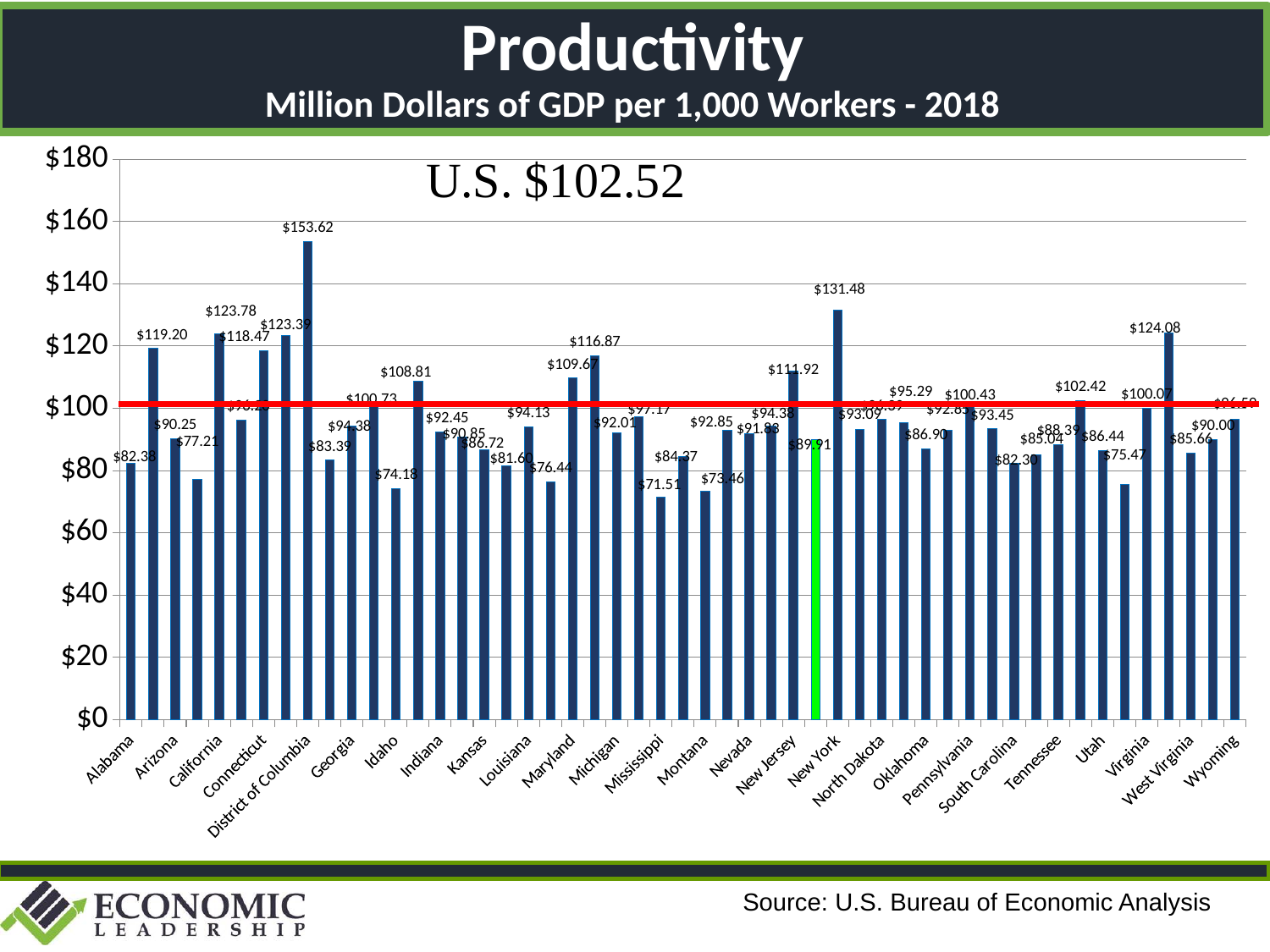
Is the productivity value for Montana greater or less than $80? less What is the productivity value shown for Virginia? $100.07 What is the difference between the productivity values of New York and New Jersey? $19.56 What type of chart is shown on the slide? Bar chart Which has a higher productivity value, Maryland or Michigan? Maryland Which state has the lowest productivity on the chart? Mississippi What is the productivity value shown for Mississippi? $71.51 What U.S. value is printed on the chart? $102.52 What is the productivity value shown for New York? $131.48 Which state or district has the highest productivity on the chart? District of Columbia What is the productivity value shown for the District of Columbia? $153.62 What is the productivity value shown for California? $123.78